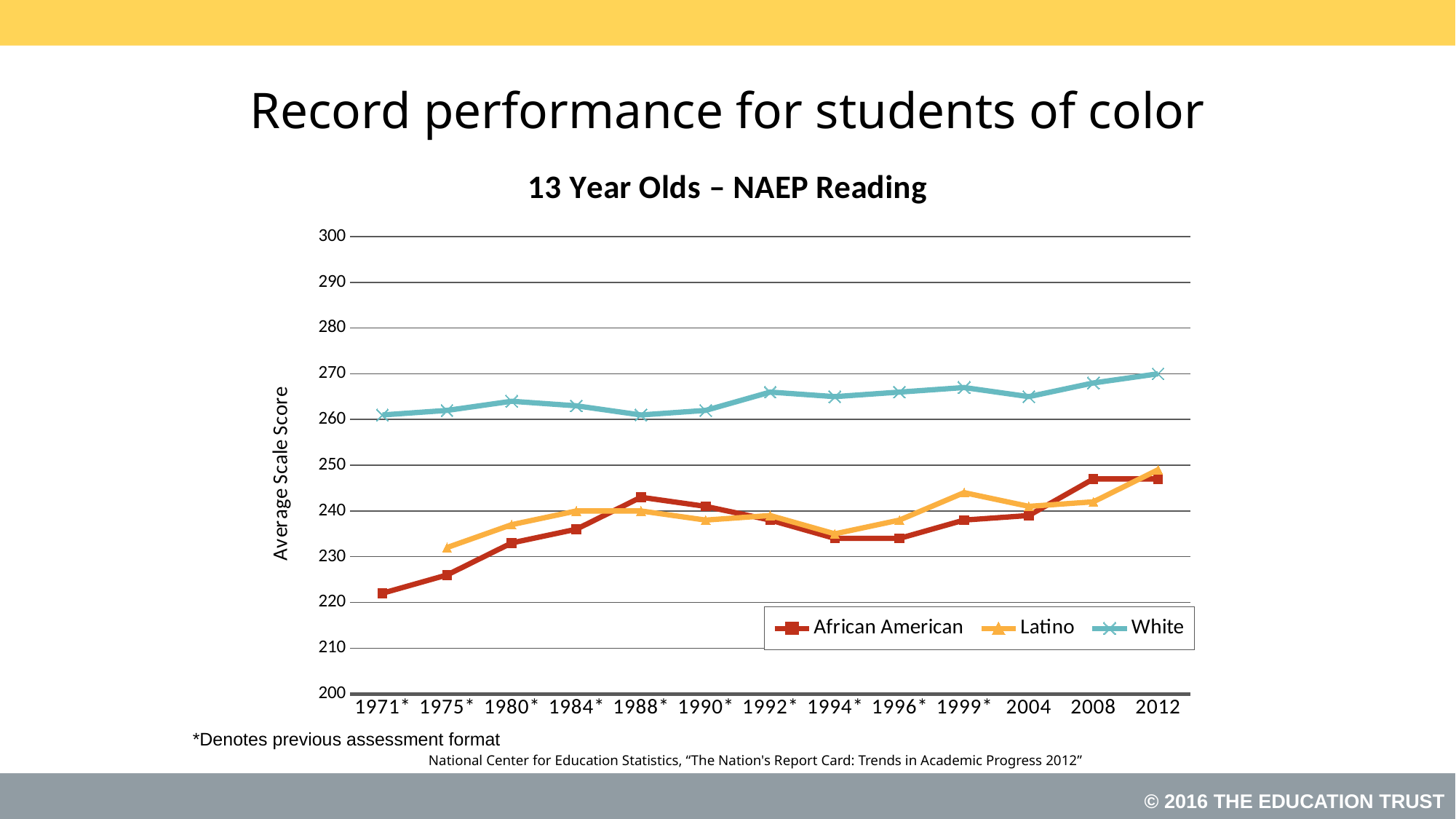
What is the label on the y axis? Average Scale Score Is the African American value for 1971* greater or less than 230? less What kind of chart is shown on the slide? line chart Does the White series rise or fall overall from 1971* to 2012? rise What is the White average scale score in 2012? 270 Which series has the highest value in 2012? White Is the Latino value for 1999* greater or less than 240? greater In which year is the African American series at its lowest? 1971* What is the Latino average scale score in 1984*? 240 How many series does the legend list? 3 How many years are shown along the x axis? 13